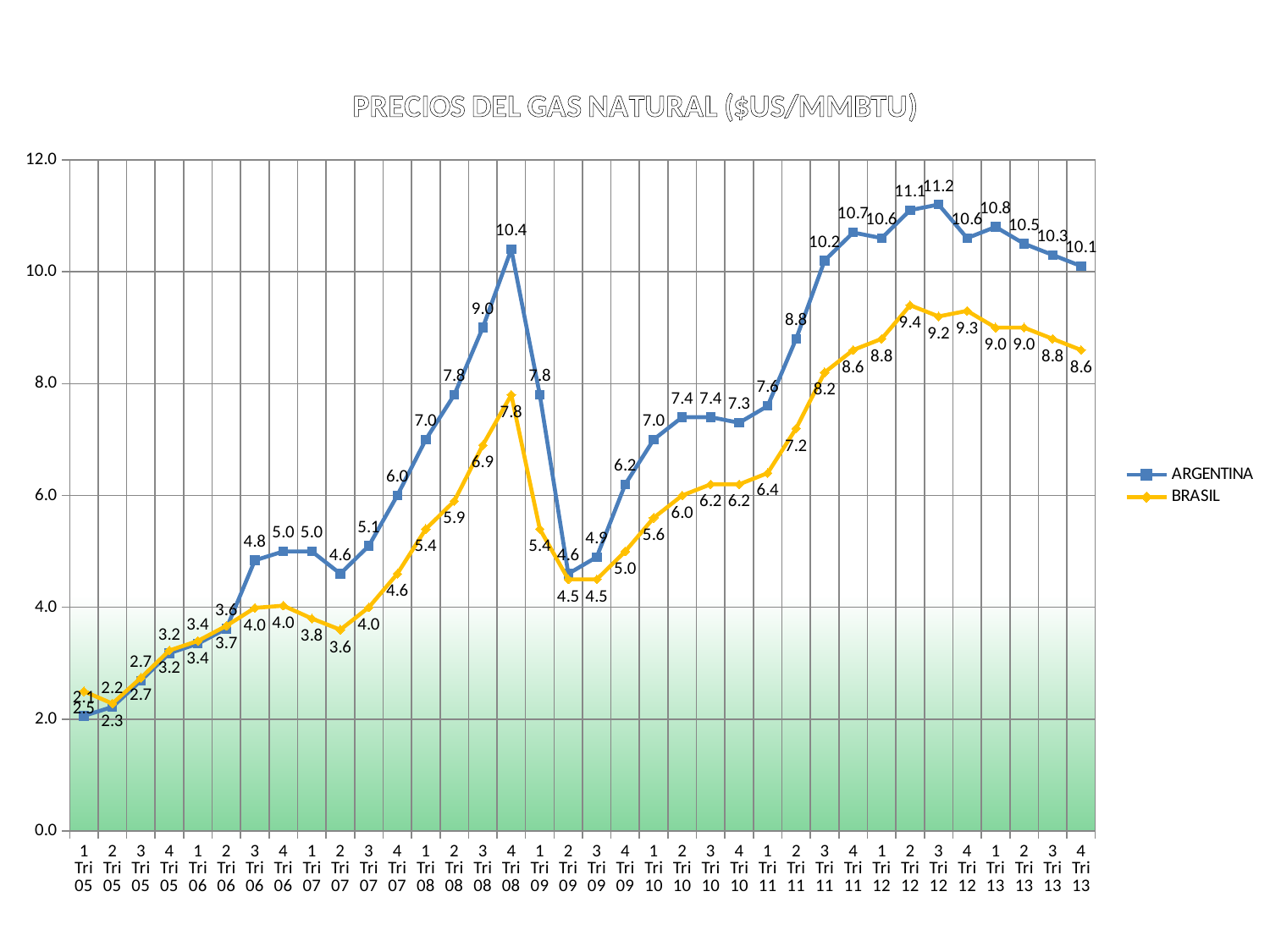
In which quarter does the ARGENTINA series reach its highest value? 3 Tri 12 Is the value for ARGENTINA in 3 Tri 11 greater or less than 10.0? greater Which series has the higher value in 1 Tri 05, ARGENTINA or BRASIL? BRASIL How many quarters are plotted on the x axis? 36 What type of chart is shown on the slide? line chart In which quarter does the BRASIL series reach its lowest value? 2 Tri 05 What is the difference between the ARGENTINA and BRASIL values in 4 Tri 08? 2.6 What is the value for ARGENTINA in 4 Tri 08? 10.4 What is the value for BRASIL in 2 Tri 12? 9.4 How many series does the legend list? 2 What is the value for BRASIL in 4 Tri 13? 8.6 What is the title of the chart? PRECIOS DEL GAS NATURAL ($US/MMBTU)